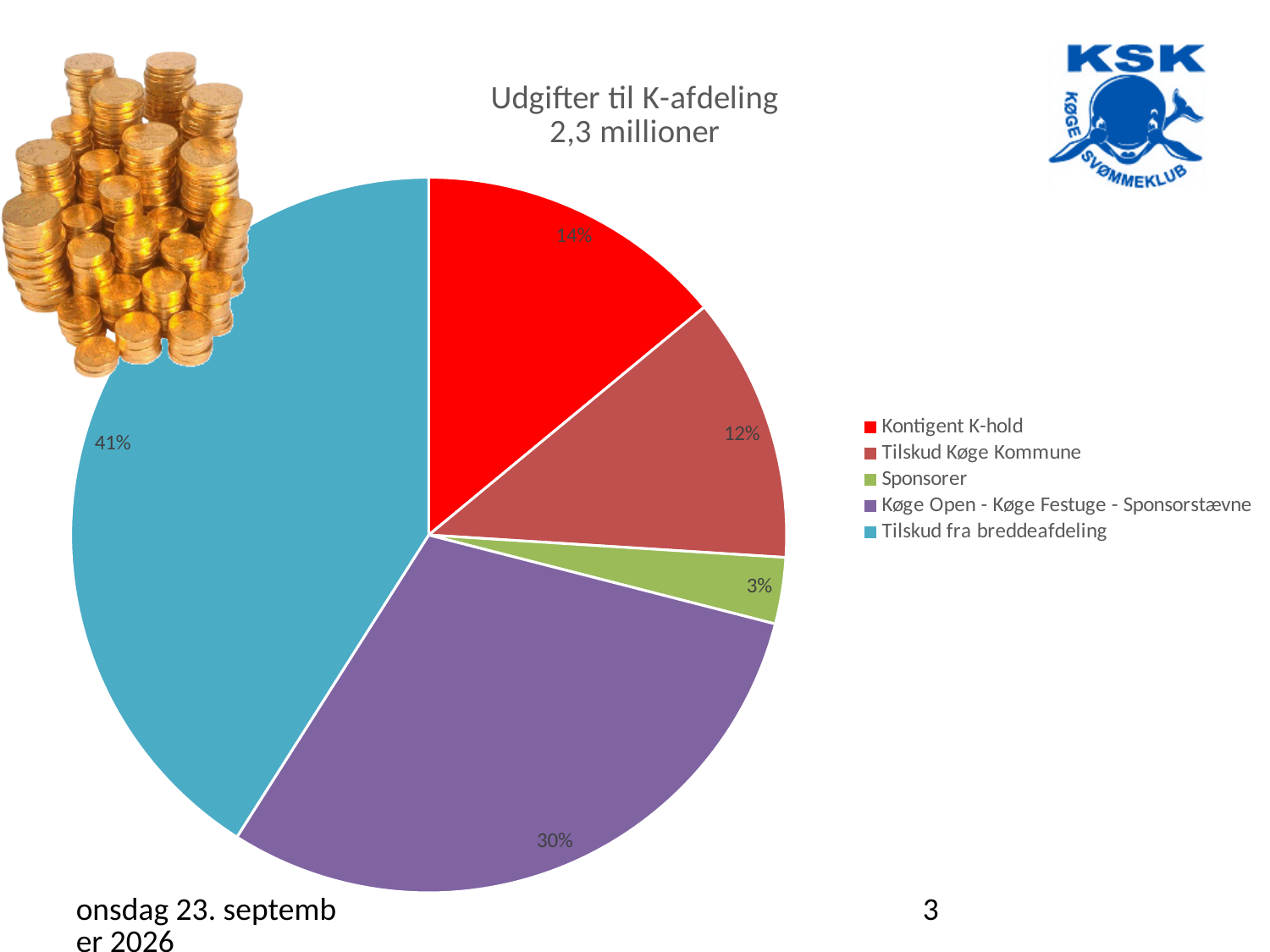
How many entries does the legend list? 5 What share of the pie is Kontigent K-hold? 14% What is the difference in percentage points between Tilskud fra breddeafdeling and Køge Open - Køge Festuge - Sponsorstævne? 11% What is the title of the chart? Udgifter til K-afdeling 2,3 millioner What share of the pie is Tilskud fra breddeafdeling? 41% What share of the pie is Tilskud Køge Kommune? 12% Which category has the largest slice? Tilskud fra breddeafdeling What kind of chart is shown on the slide? pie chart How many slices does the pie chart have? 5 Which category has the smallest slice? Sponsorer